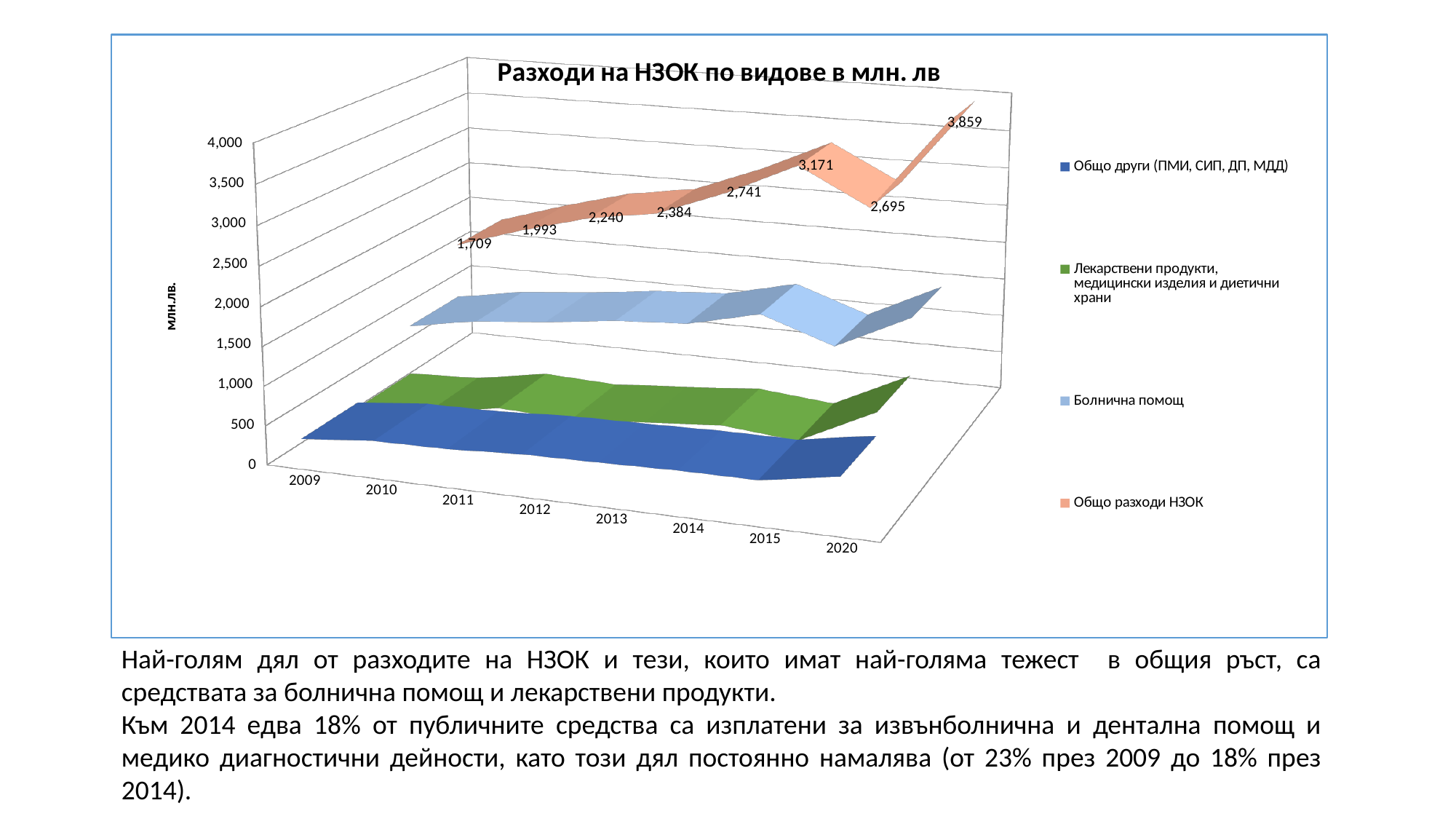
What is the value of Общо разходи НЗОК for 2015? 2,695 How many years are shown on the x axis of the chart? 8 What kind of chart is shown on the slide? 3D line chart What is the value of Общо разходи НЗОК for 2020? 3,859 In which year is Общо разходи НЗОК the highest? 2020 How many series does the legend list? 4 Which year has the larger value of Общо разходи НЗОК, 2014 or 2015? 2014 What is the value of Общо разходи НЗОК for 2009? 1,709 What is the value of Общо разходи НЗОК for 2014? 3,171 In which year is Общо разходи НЗОК the lowest? 2009 What is the difference between Общо разходи НЗОК in 2014 and in 2013? 430 What is the difference between Общо разходи НЗОК in 2020 and in 2015? 1,164